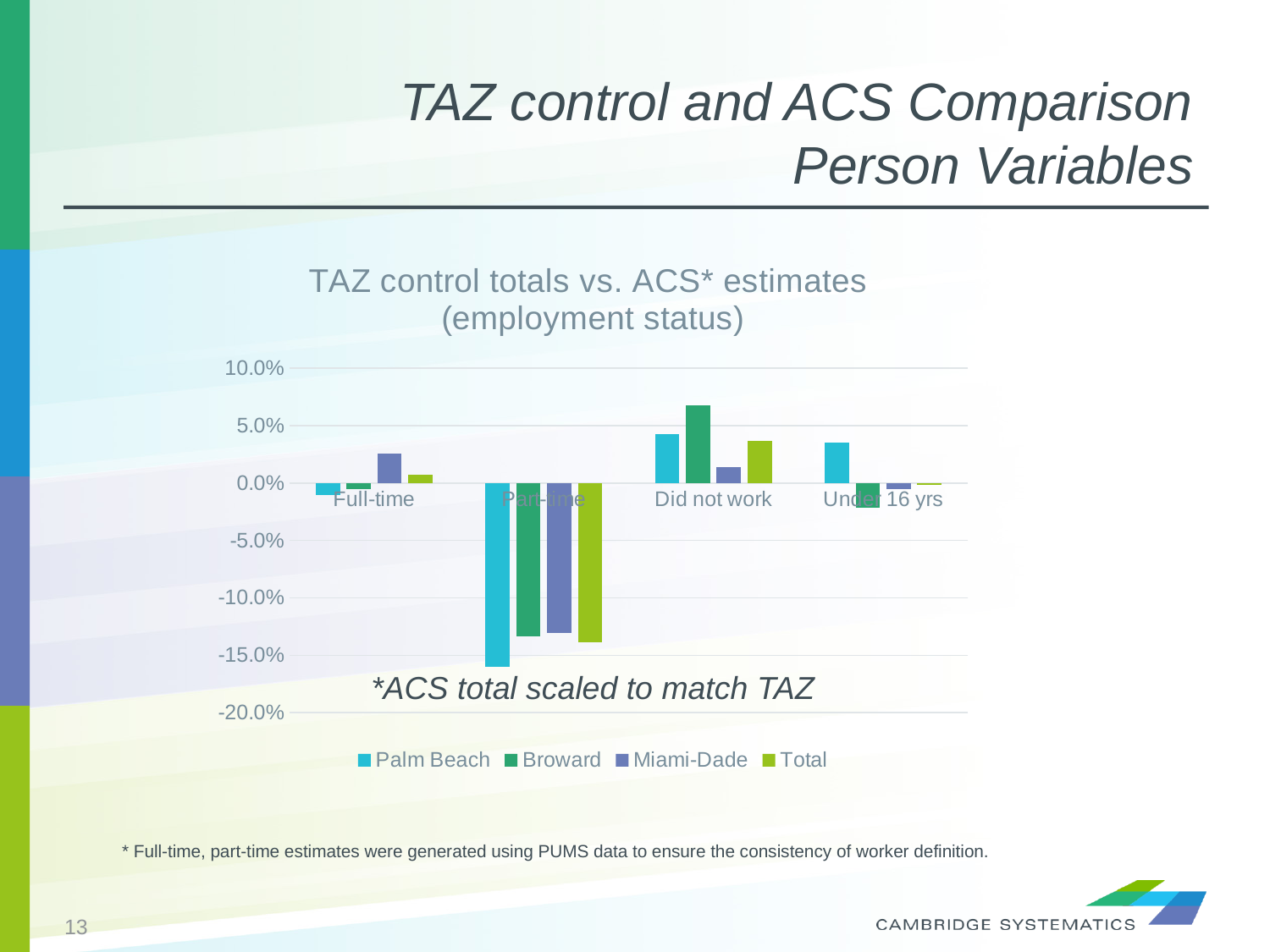
What kind of chart is shown on the slide? bar chart Is the Palm Beach value for Part-time greater or less than -15.0%? less How many series does the legend list? 4 Is the Miami-Dade value for Did not work greater or less than 5.0%? less How many employment status categories are shown on the x axis? 4 Is the Broward value for Did not work greater or less than 5.0%? greater Which series is shown in light green in the legend? Total For Did not work, which is larger: the Broward value or the Palm Beach value? Broward Which category has the highest Broward value? Did not work What is the title of the chart? TAZ control totals vs. ACS* estimates (employment status) For Part-time, which is larger: the Palm Beach value or the Broward value? Broward Which category has the lowest Palm Beach value? Part-time